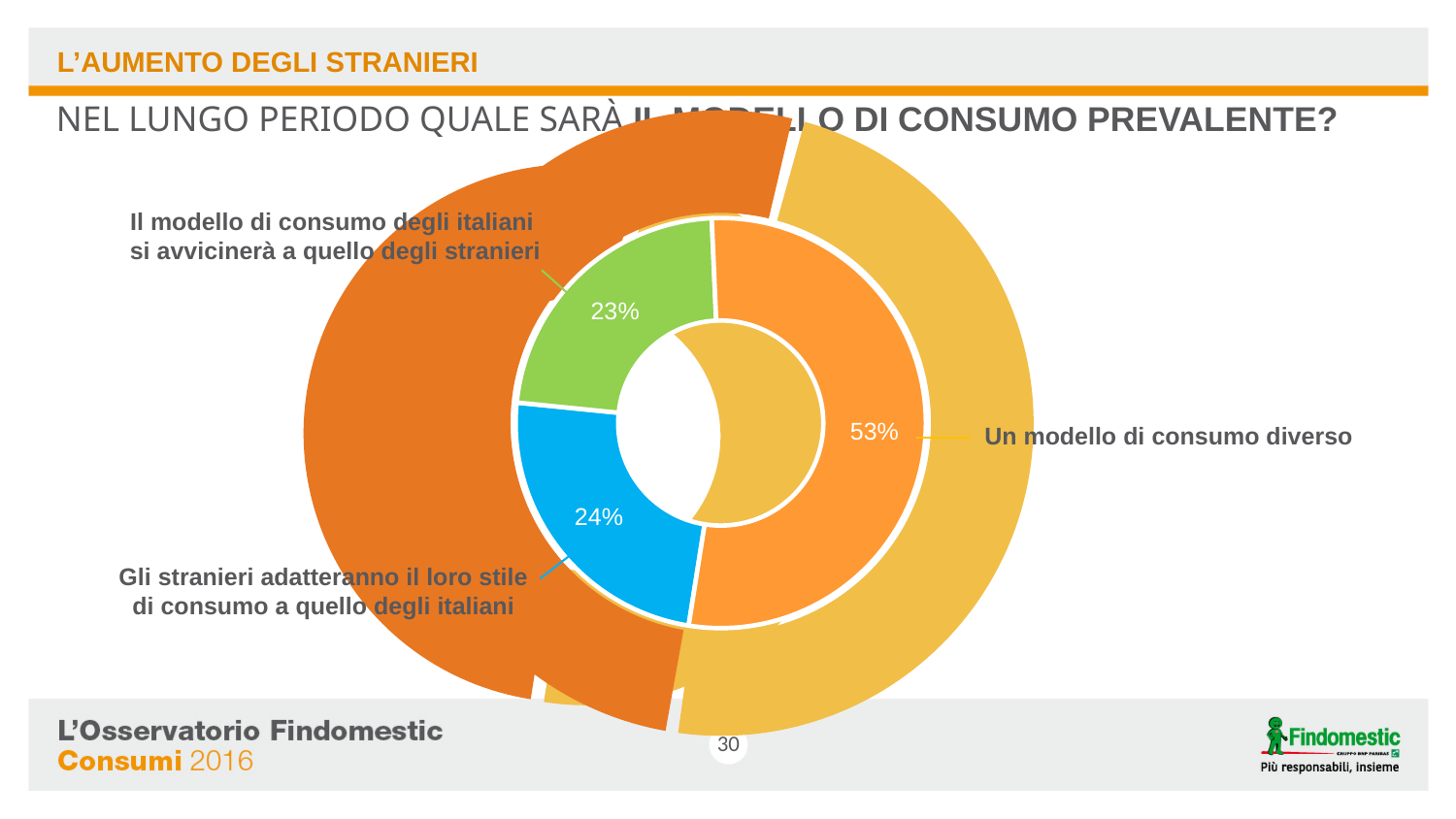
What is the difference between the 24% slice and the 23% slice? 1% What colour is the slice labelled 23%? Green How many categories are shown in the chart? 3 Which category has the smallest share in the chart? Il modello di consumo degli italiani si avvicinerà a quello degli stranieri What percentage is shown for "Il modello di consumo degli italiani si avvicinerà a quello degli stranieri"? 23% What kind of chart is shown on the slide? Doughnut chart What colour is the slice for "Un modello di consumo diverso"? Orange Which is larger: the share for "Un modello di consumo diverso" or the share for "Il modello di consumo degli italiani si avvicinerà a quello degli stranieri"? Un modello di consumo diverso What percentage is shown for "Gli stranieri adatteranno il loro stile di consumo a quello degli italiani"? 24% Which category has the largest share in the chart? Un modello di consumo diverso What percentage is shown for "Un modello di consumo diverso"? 53% What is the difference between the share for "Un modello di consumo diverso" and the share for "Gli stranieri adatteranno il loro stile di consumo a quello degli italiani"? 29%